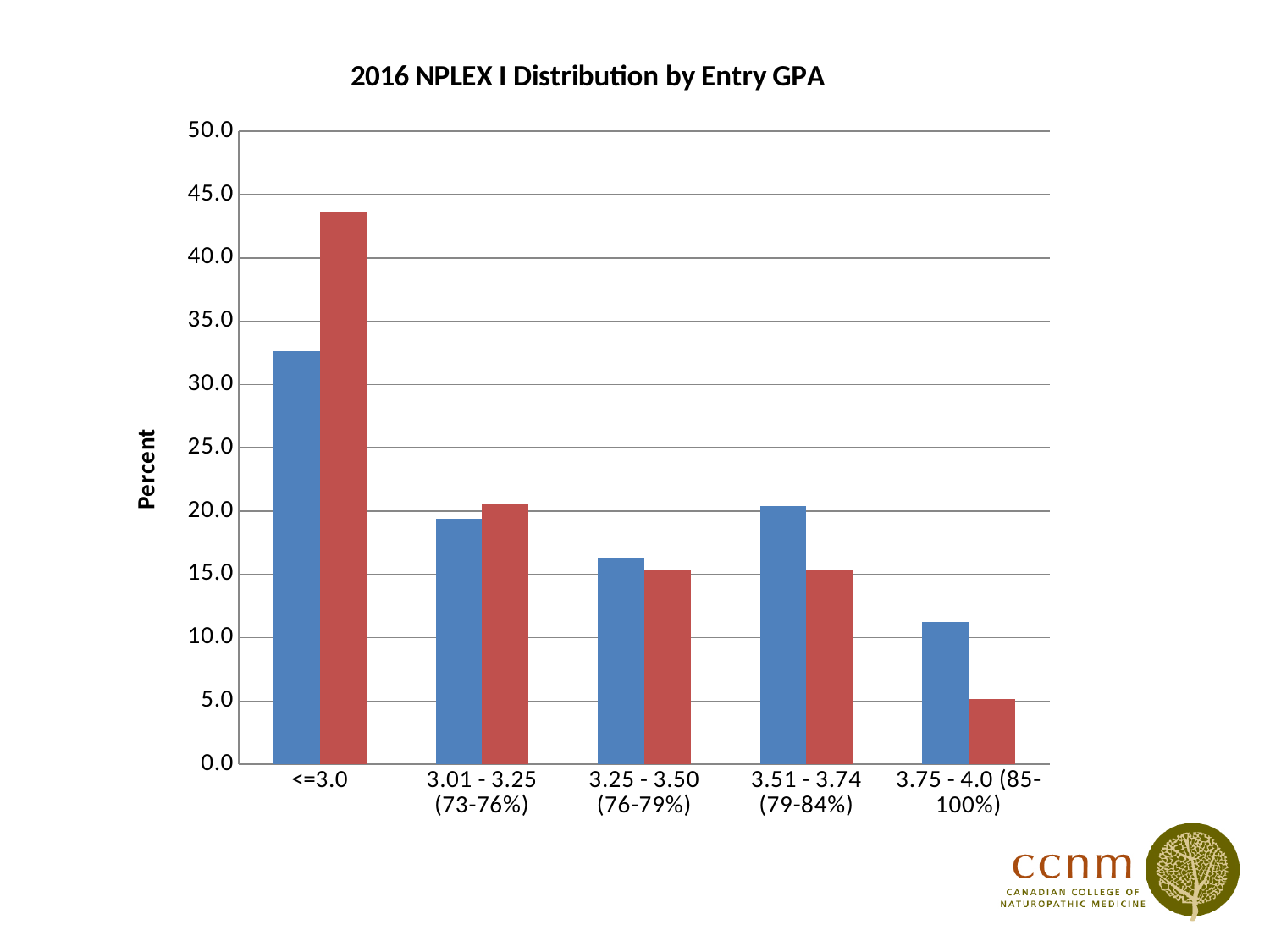
What kind of chart is shown on the slide? Bar chart What is the title of the chart? 2016 NPLEX I Distribution by Entry GPA What is the label on the vertical axis of the chart? Percent Is the red bar for 3.75 - 4.0 (85-100%) greater or less than 10.0? less Is the red bar for <=3.0 greater or less than 40.0? greater For the <=3.0 category, which bar is taller, the blue or the red? Red Which GPA category has the tallest blue bar? <=3.0 Do the red bars rise or fall moving from <=3.0 to 3.75 - 4.0 (85-100%)? Fall Is the blue bar for 3.75 - 4.0 (85-100%) greater or less than 10.0? greater How many GPA categories are shown on the x axis? 5 How many bars are plotted for each GPA category? 2 Which GPA category has the shortest red bar? 3.75 - 4.0 (85-100%)